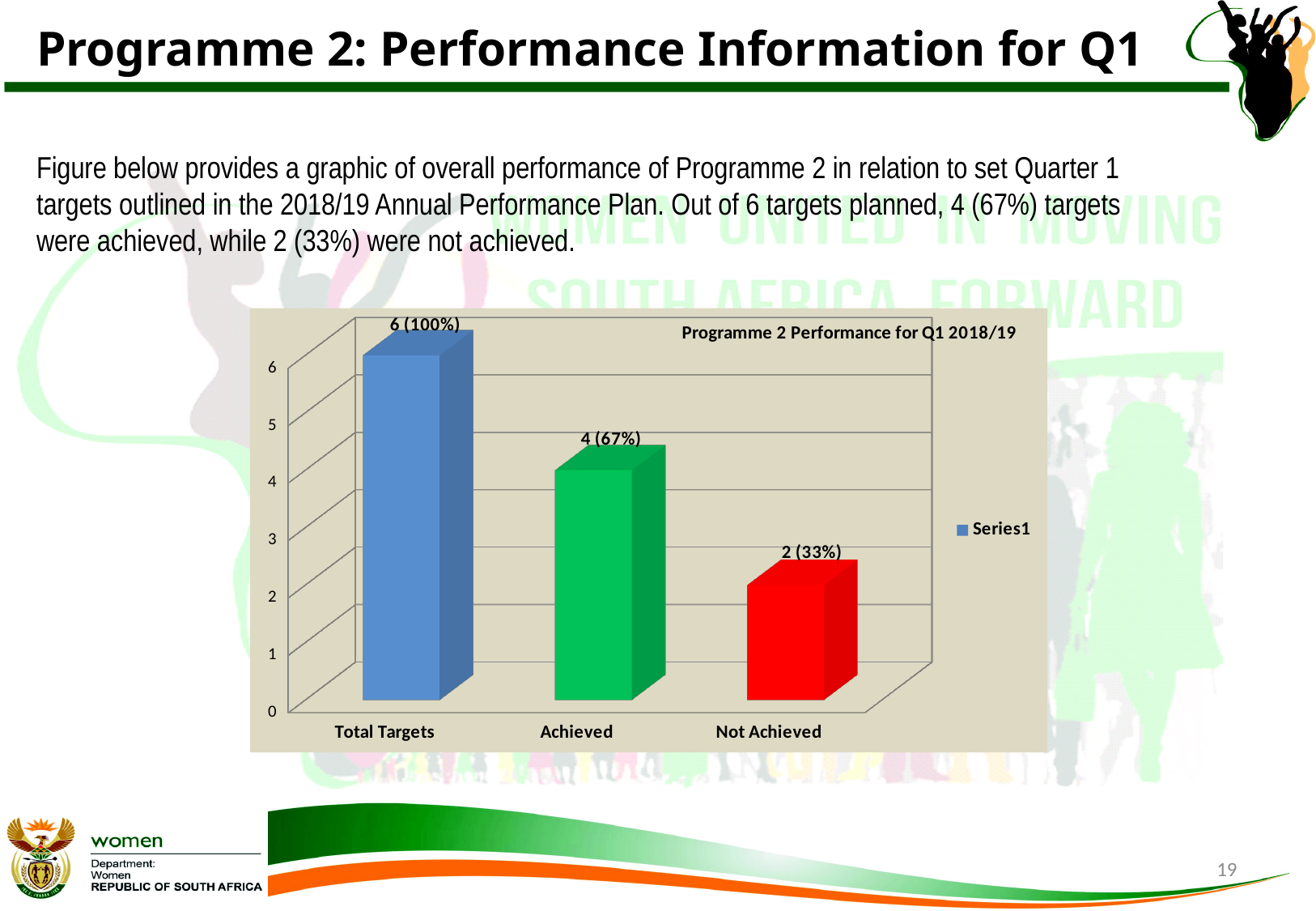
How many categories are shown on the x axis? 3 Which category has the lowest value? Not Achieved What is the data label shown for Achieved? 4 (67%) What kind of chart is shown on the slide? Bar chart Which is larger, the value for Achieved or the value for Not Achieved? Achieved What is the difference between the number of targets Achieved and Not Achieved? 2 What is the data label shown for Total Targets? 6 (100%) What is the data label shown for Not Achieved? 2 (33%) What is the title of the chart? Programme 2 Performance for Q1 2018/19 How many series does the legend list? 1 Is the value for Achieved greater or less than 3? greater Which category has the highest value? Total Targets